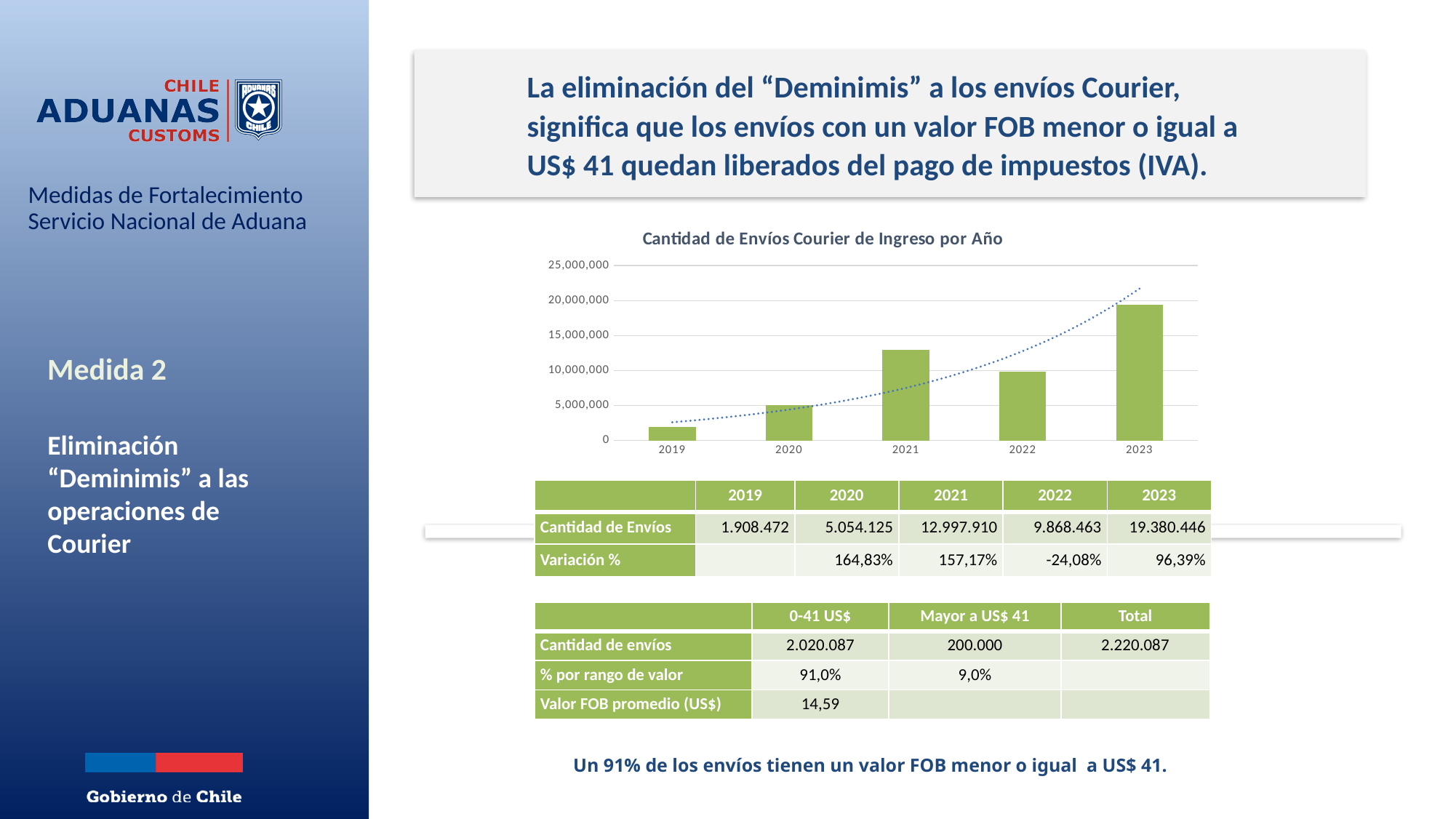
Which year has the lowest bar in the "Cantidad de Envíos Courier de Ingreso por Año" chart? 2019 What kind of chart is shown under the title "Cantidad de Envíos Courier de Ingreso por Año"? bar chart How many years are plotted in the "Cantidad de Envíos Courier de Ingreso por Año" chart? 5 In the chart, does the value rise or fall from 2021 to 2022? fall In the chart, is the value for 2019 greater or less than 5,000,000? less In the chart, is the value for 2022 greater or less than 5,000,000? greater What is the title of the chart on the slide? Cantidad de Envíos Courier de Ingreso por Año According to the table below the chart, what is the Cantidad de Envíos for 2019? 1.908.472 According to the table below the chart, what is the Cantidad de Envíos for 2023? 19.380.446 In the chart, which year has the larger value, 2021 or 2022? 2021 Which year has the highest bar in the "Cantidad de Envíos Courier de Ingreso por Año" chart? 2023 In the chart, is the value for 2021 greater or less than 10,000,000? greater